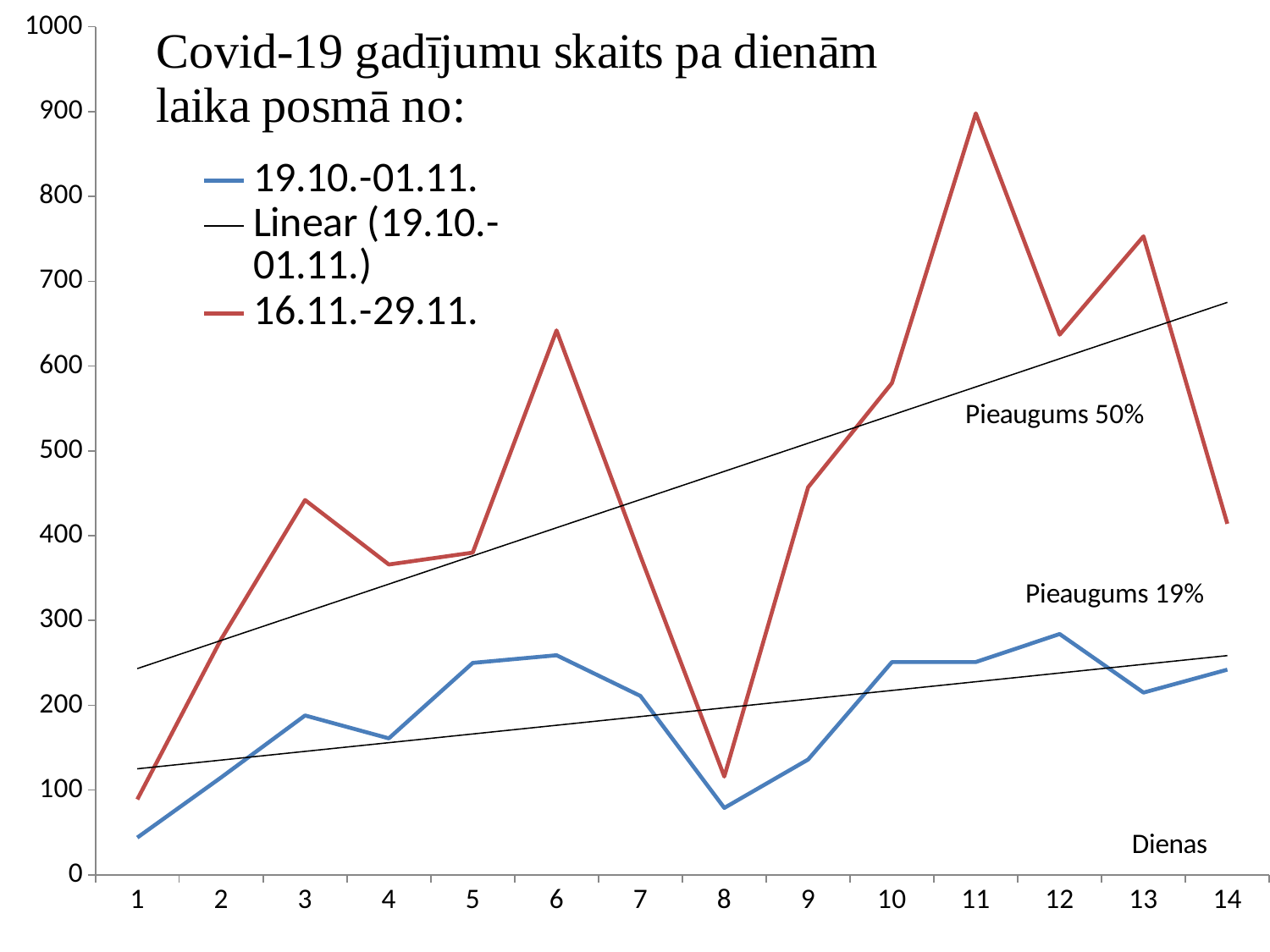
Is the value for the 16.11.-29.11. series on day 11 greater or less than 800? greater According to the linear trendlines, do the values of both series rise or fall over the 14 days? rise On which day does the 19.10.-01.11. series reach its highest value? 12 How many entries does the legend list? 3 What kind of chart is shown on the slide? line chart On day 6, which series has the larger value, 19.10.-01.11. or 16.11.-29.11.? 16.11.-29.11. How many days are plotted along the x axis? 14 Is the value for the 19.10.-01.11. series on day 8 greater or less than 100? less On which day does the 16.11.-29.11. series reach its highest value? 11 On which day does the 19.10.-01.11. series have its lowest value? 1 What percentage increase is annotated next to the trendline of the 16.11.-29.11. series? Pieaugums 50% Is the value for the 16.11.-29.11. series on day 8 greater or less than 200? less